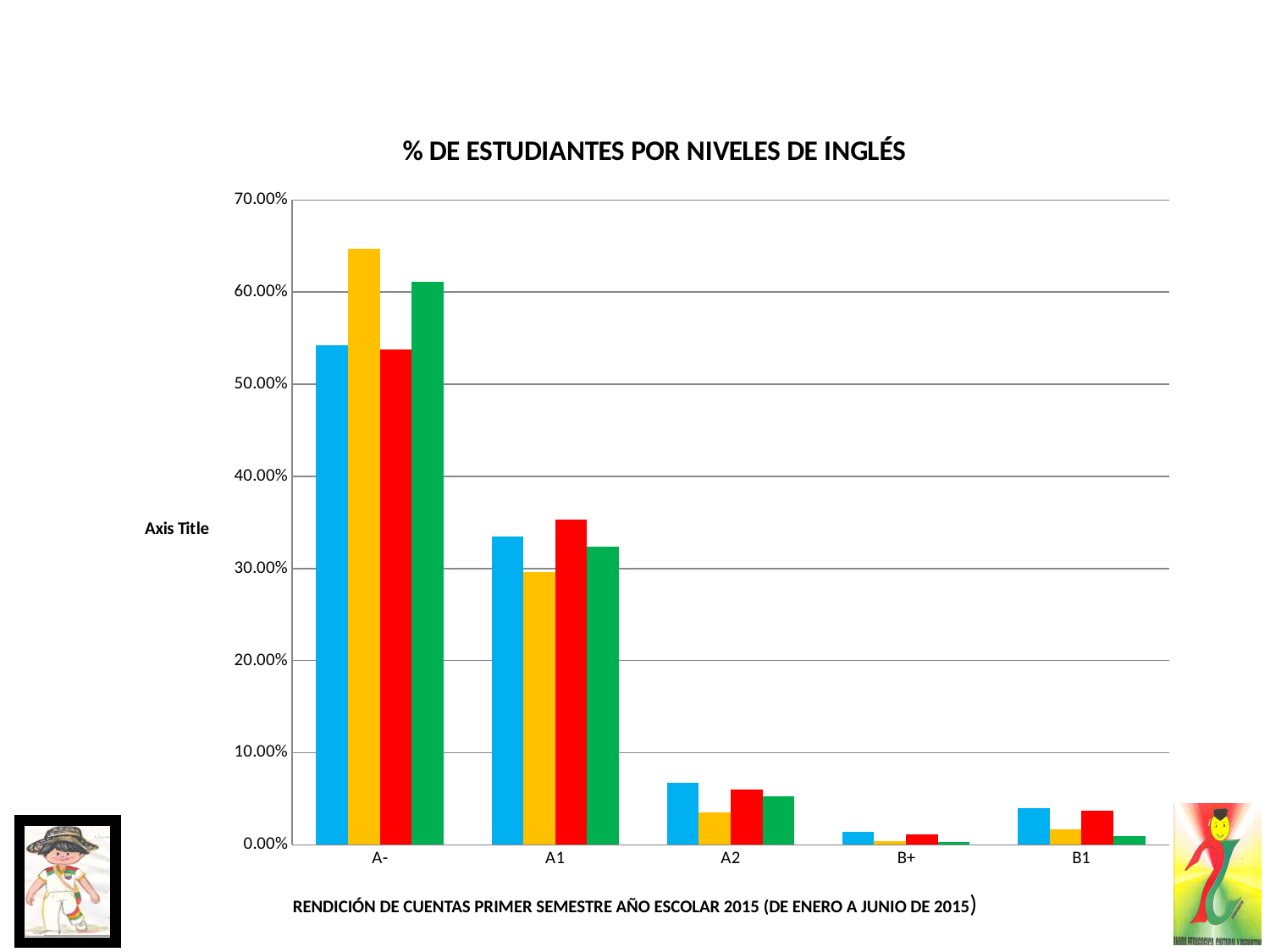
What is the title of the chart? % DE ESTUDIANTES POR NIVELES DE INGLÉS For the A- level, which bar is taller, the yellow bar or the blue bar? yellow bar How many English level categories are shown on the x axis? 5 Which level category has the highest percentages of students? A- Is the value of the red bar for A1 greater or less than 30.00%? greater How many bars are plotted for each level category? 4 Is the value of the blue bar for A- greater or less than 50.00%? greater Which level category has the lowest percentages of students? B+ Is the value of the yellow bar for A- greater or less than 60.00%? greater What kind of chart is shown on the slide? bar chart Do the percentages generally rise or fall moving from A- to B+ along the x axis? fall